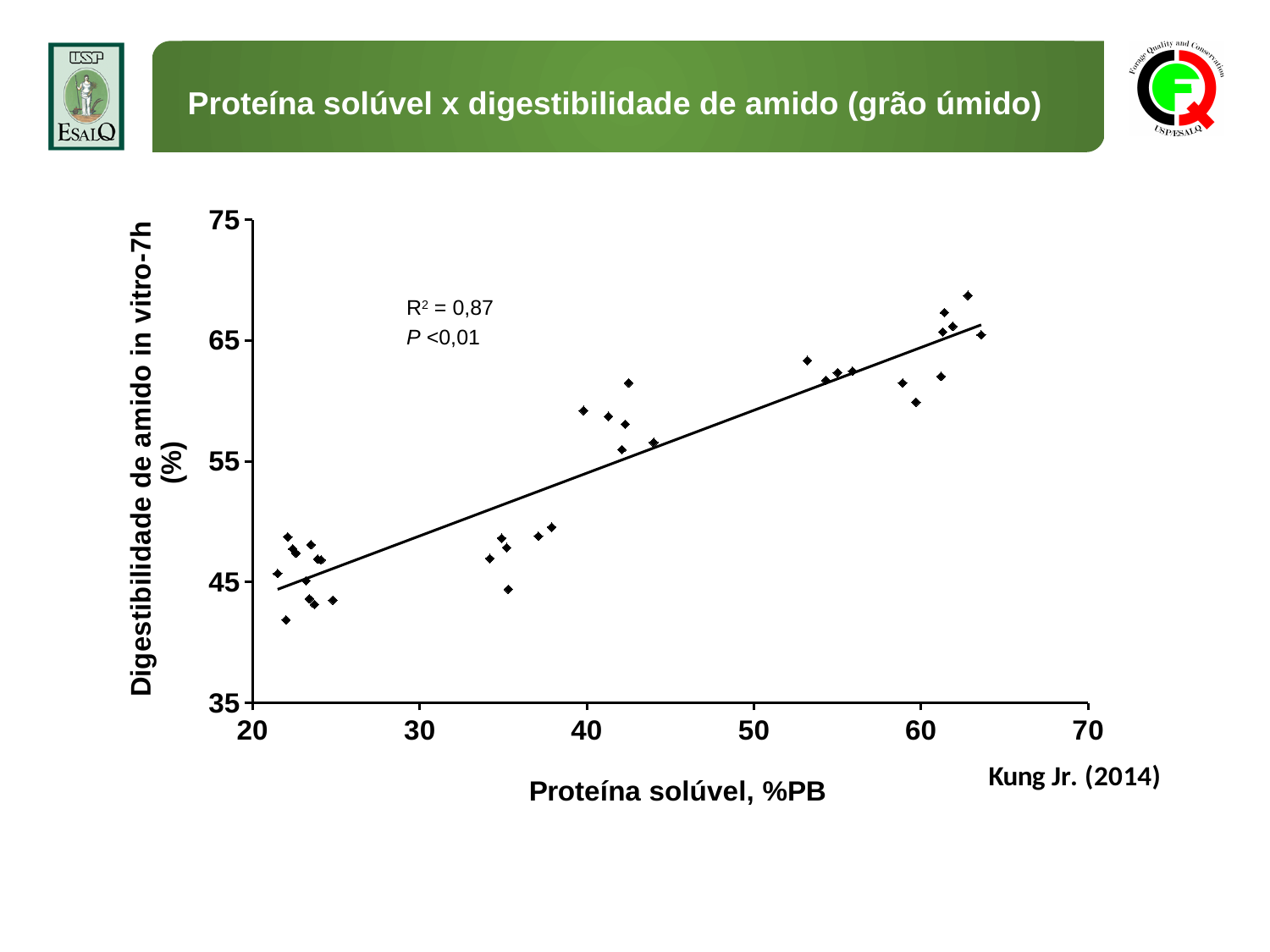
How many data series are plotted on the chart? 1 Is the smallest soluble protein value among the plotted points greater or less than 20? greater What kind of chart is shown on the slide? Scatter plot What P value is printed on the chart? P <0,01 Is the digestibility of the points plotted near 35 %PB soluble protein greater or less than 55? less Is the digestibility of the points plotted near 60 %PB soluble protein greater or less than 55? greater What R² value is printed on the chart? R² = 0,87 Do the plotted digestibility values rise or fall as soluble protein increases along the x axis? Rise